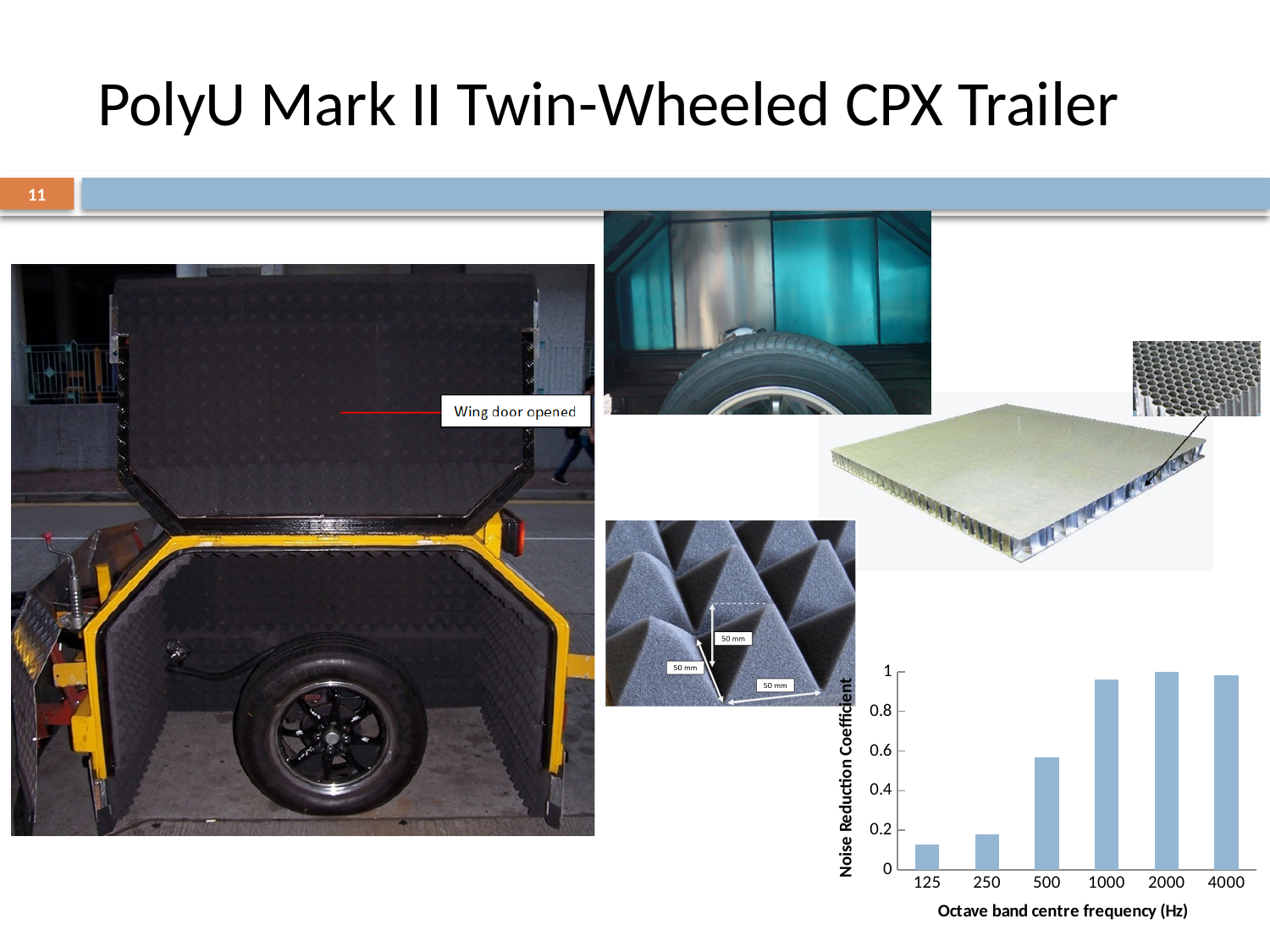
What is the label of the horizontal axis of the chart? Octave band centre frequency (Hz) What kind of chart is shown on the slide? bar chart Is the Noise Reduction Coefficient at 1000 Hz greater or less than 0.8? greater What is the label of the vertical axis of the chart? Noise Reduction Coefficient Is the Noise Reduction Coefficient at 125 Hz greater or less than 0.2? less Does the Noise Reduction Coefficient generally rise or fall as the octave band centre frequency increases from 125 Hz to 2000 Hz? rise Which has a higher Noise Reduction Coefficient, 250 Hz or 500 Hz? 500 Hz How many octave band centre frequencies are plotted in the chart? 6 Is the Noise Reduction Coefficient at 500 Hz greater or less than 0.4? greater Which has a higher Noise Reduction Coefficient, 500 Hz or 1000 Hz? 1000 Hz